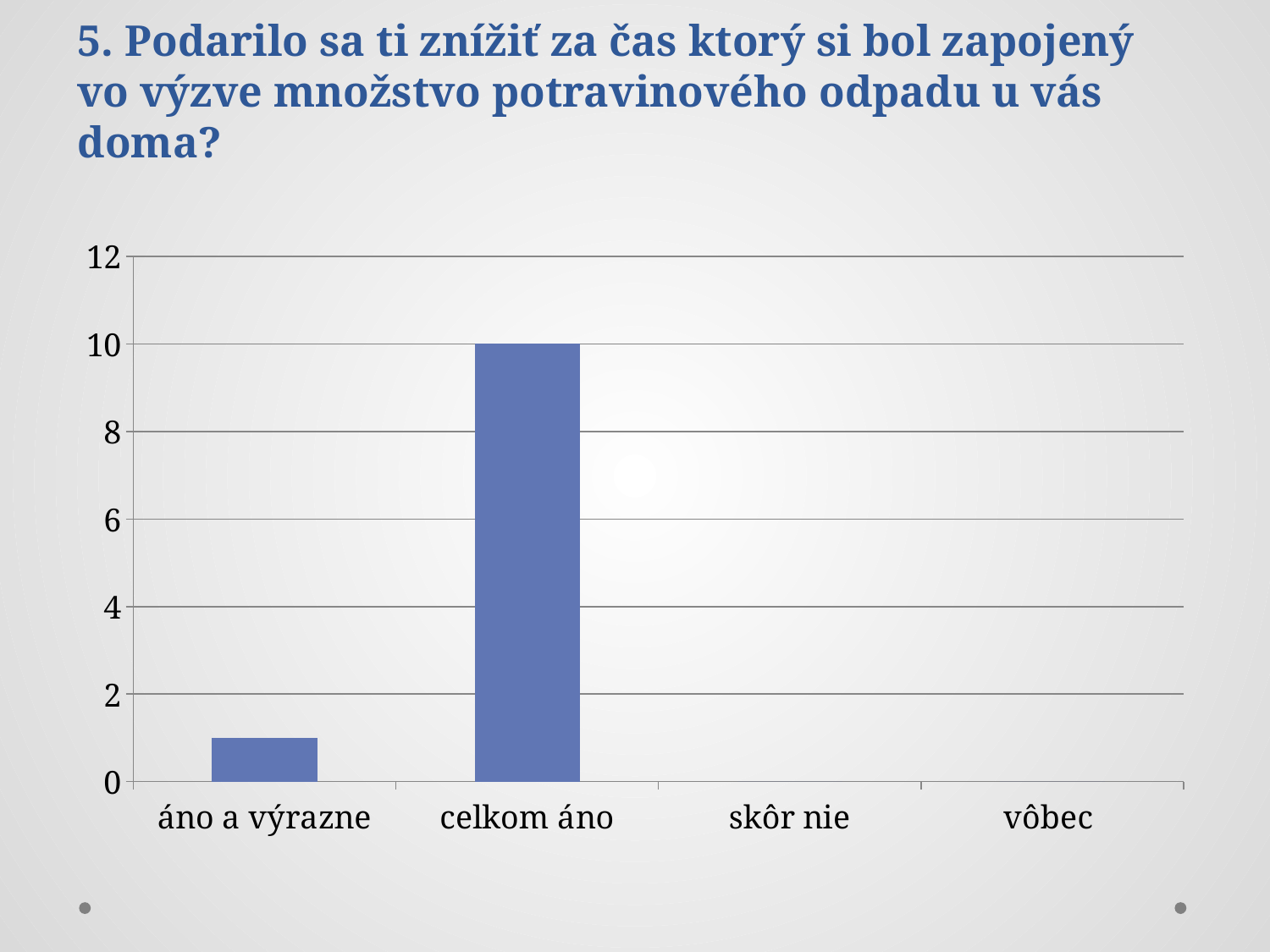
What kind of chart is shown on the slide? bar chart What is the value for "vôbec"? 0 Which is larger, the value for "celkom áno" or the value for "áno a výrazne"? celkom áno Is the value for "celkom áno" greater or less than 8? greater How many categories are shown on the x axis? 4 Is the value for "áno a výrazne" greater or less than 2? less What is the value for "skôr nie"? 0 What is the value for "celkom áno"? 10 Which category has the highest value? celkom áno What is the highest value shown on the y axis? 12 What is the label of the second category on the x axis? celkom áno